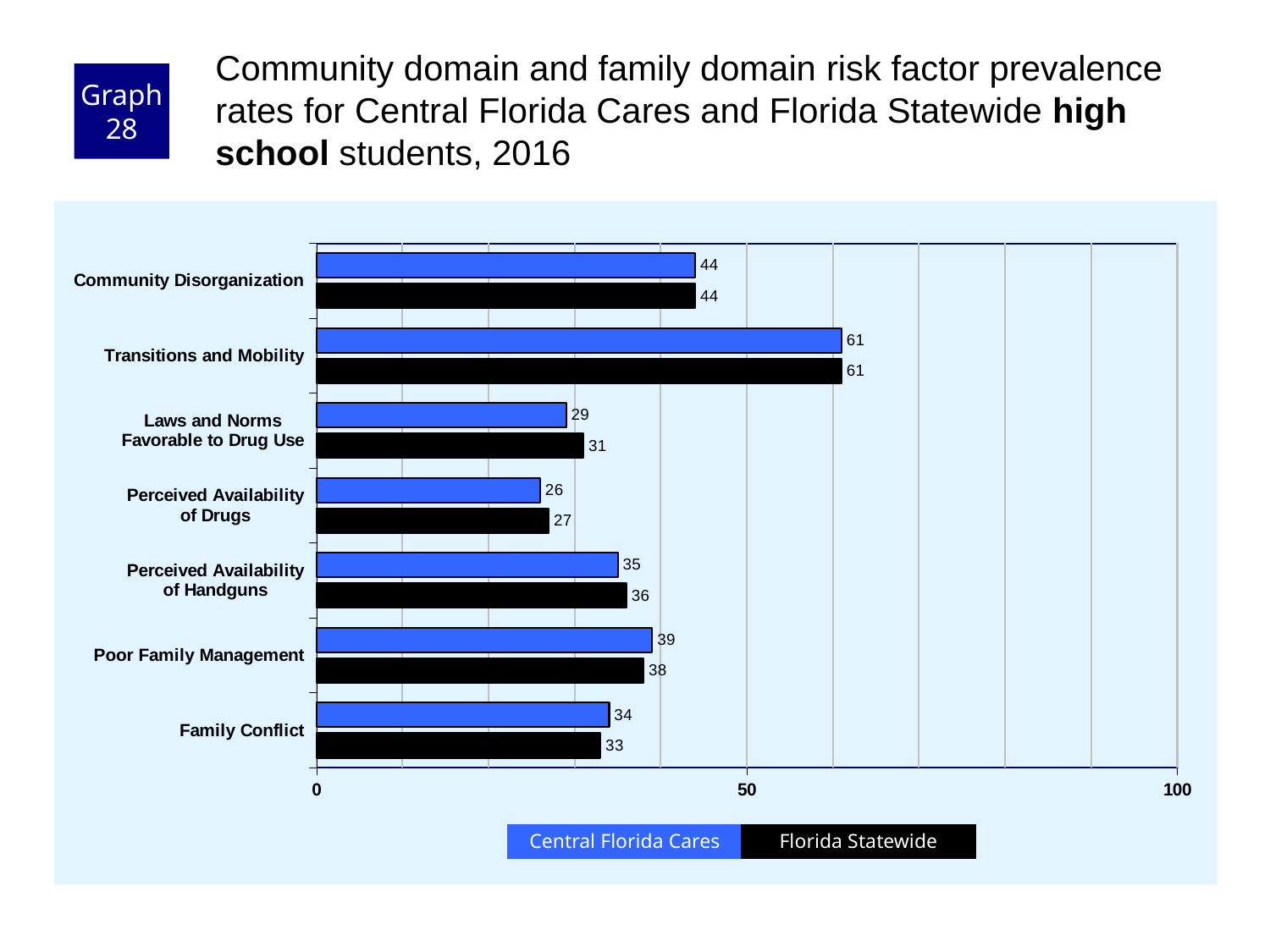
What kind of chart is shown on the slide? bar chart Is the Central Florida Cares value for Transitions and Mobility greater or less than 50? greater Which risk factor has the lowest Florida Statewide value? Perceived Availability of Drugs Which colour represents Florida Statewide in the chart? black How many series does the legend list? 2 Which is larger for Poor Family Management: the Central Florida Cares value or the Florida Statewide value? Central Florida Cares What is the Florida Statewide value for Laws and Norms Favorable to Drug Use? 31 What is the Central Florida Cares value for Transitions and Mobility? 61 What is the difference between the Florida Statewide and Central Florida Cares values for Laws and Norms Favorable to Drug Use? 2 What is the Central Florida Cares value for Family Conflict? 34 How many risk factors are shown on the chart? 7 Which risk factor has the highest Central Florida Cares value? Transitions and Mobility